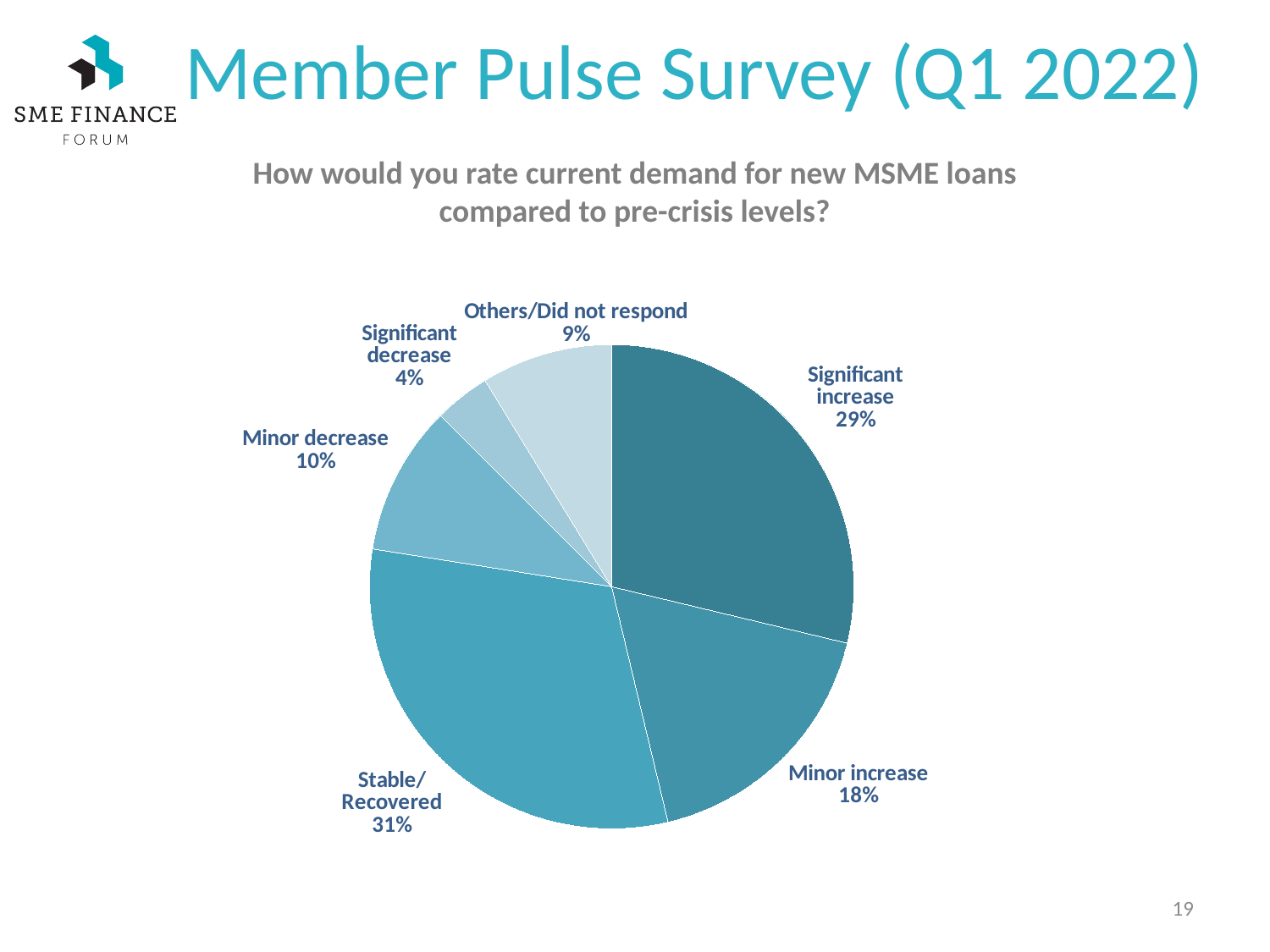
What share of respondents rated demand as a Minor decrease? 10% What share of respondents rated demand as Stable/Recovered? 31% Which is larger, the share for Minor decrease or the share for Others/Did not respond? Minor decrease Which category has the smallest share of the pie? Significant decrease What is the difference in percentage points between Significant increase and Minor increase? 11 What share of respondents rated demand as a Significant increase? 29% Which category has the largest share of the pie? Stable/Recovered What share of respondents rated demand as a Significant decrease? 4% What kind of chart is shown on the slide? Pie chart What share of respondents rated demand as a Minor increase? 18% How many categories are shown in the pie chart? 6 What share of respondents fall under Others/Did not respond? 9%